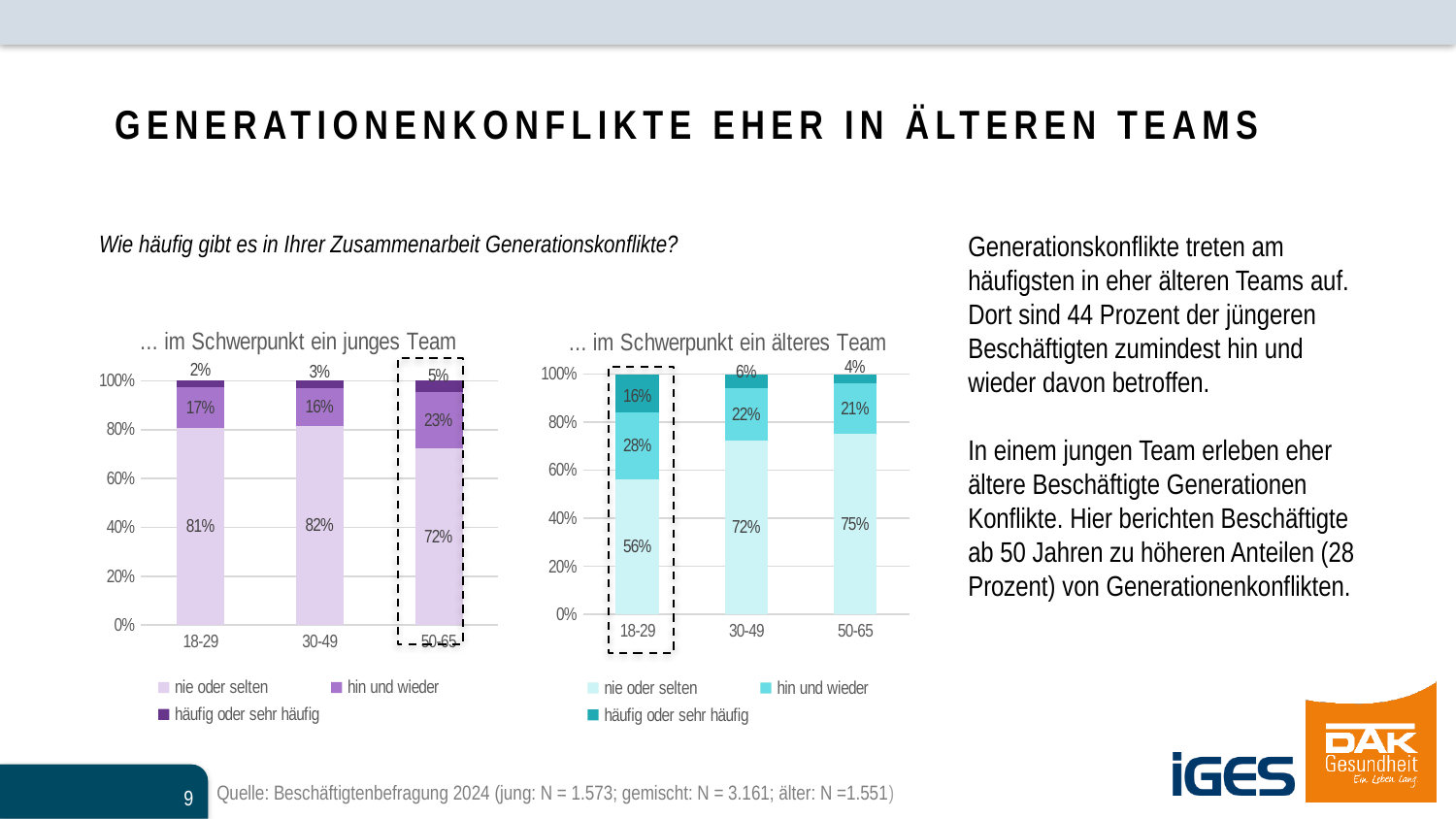
In the chart '… im Schwerpunkt ein junges Team', which age group has the highest value for 'hin und wieder'? 50-65 In the chart '… im Schwerpunkt ein junges Team', what is the value of 'nie oder selten' for the 18-29 group? 81% In the chart '… im Schwerpunkt ein junges Team', what is the difference between the 'nie oder selten' values for 30-49 and 50-65? 10 percentage points In the chart '… im Schwerpunkt ein älteres Team', what is the combined share of 'hin und wieder' and 'häufig oder sehr häufig' for the 18-29 group? 44% In the chart '… im Schwerpunkt ein älteres Team', which age group has the lowest value for 'nie oder selten'? 18-29 In the chart '… im Schwerpunkt ein junges Team', what is the value of 'häufig oder sehr häufig' for the 50-65 group? 5% In the chart '… im Schwerpunkt ein älteres Team', is the 'nie oder selten' value for 30-49 or for 50-65 larger? 50-65 What type of chart is '… im Schwerpunkt ein junges Team'? Stacked bar chart How many series does the legend of the chart '… im Schwerpunkt ein älteres Team' list? 3 How many age groups are shown in the chart '… im Schwerpunkt ein junges Team'? 3 In the chart '… im Schwerpunkt ein älteres Team', what is the value of 'hin und wieder' for the 18-29 group? 28% In the chart '… im Schwerpunkt ein älteres Team', what is the value of 'häufig oder sehr häufig' for the 18-29 group? 16%